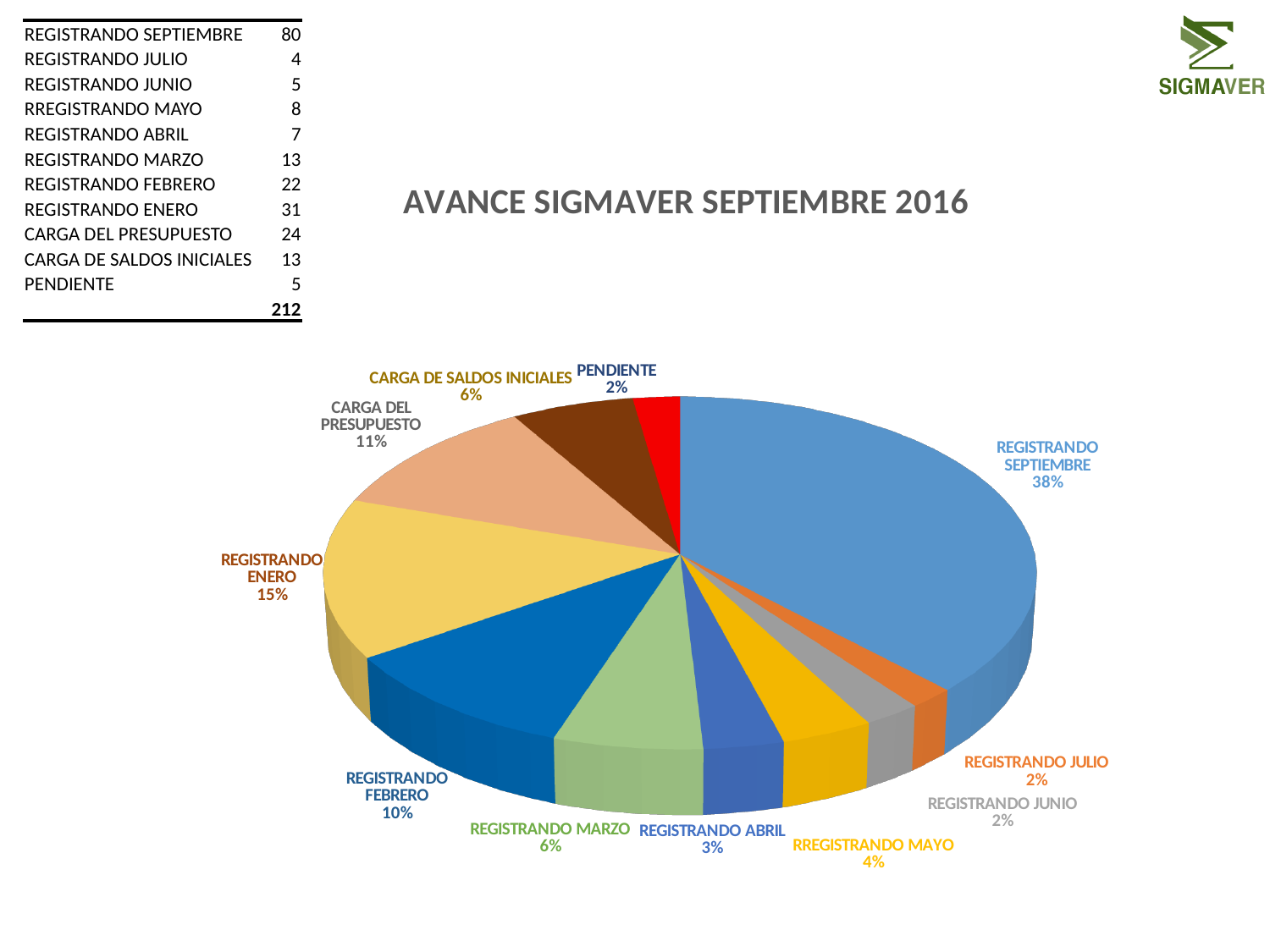
Which slice of the pie chart is the largest? REGISTRANDO SEPTIEMBRE What type of chart is shown on the slide? pie chart What share of the pie does PENDIENTE represent? 2% What is the difference in percentage points between the REGISTRANDO SEPTIEMBRE slice and the REGISTRANDO ENERO slice? 23 What share of the pie does REGISTRANDO ENERO represent? 15% How many slices does the pie chart have? 11 What share of the pie does REGISTRANDO FEBRERO represent? 10% What is the title of the chart? AVANCE SIGMAVER SEPTIEMBRE 2016 Which is larger in the pie chart, REGISTRANDO ENERO or REGISTRANDO FEBRERO? REGISTRANDO ENERO